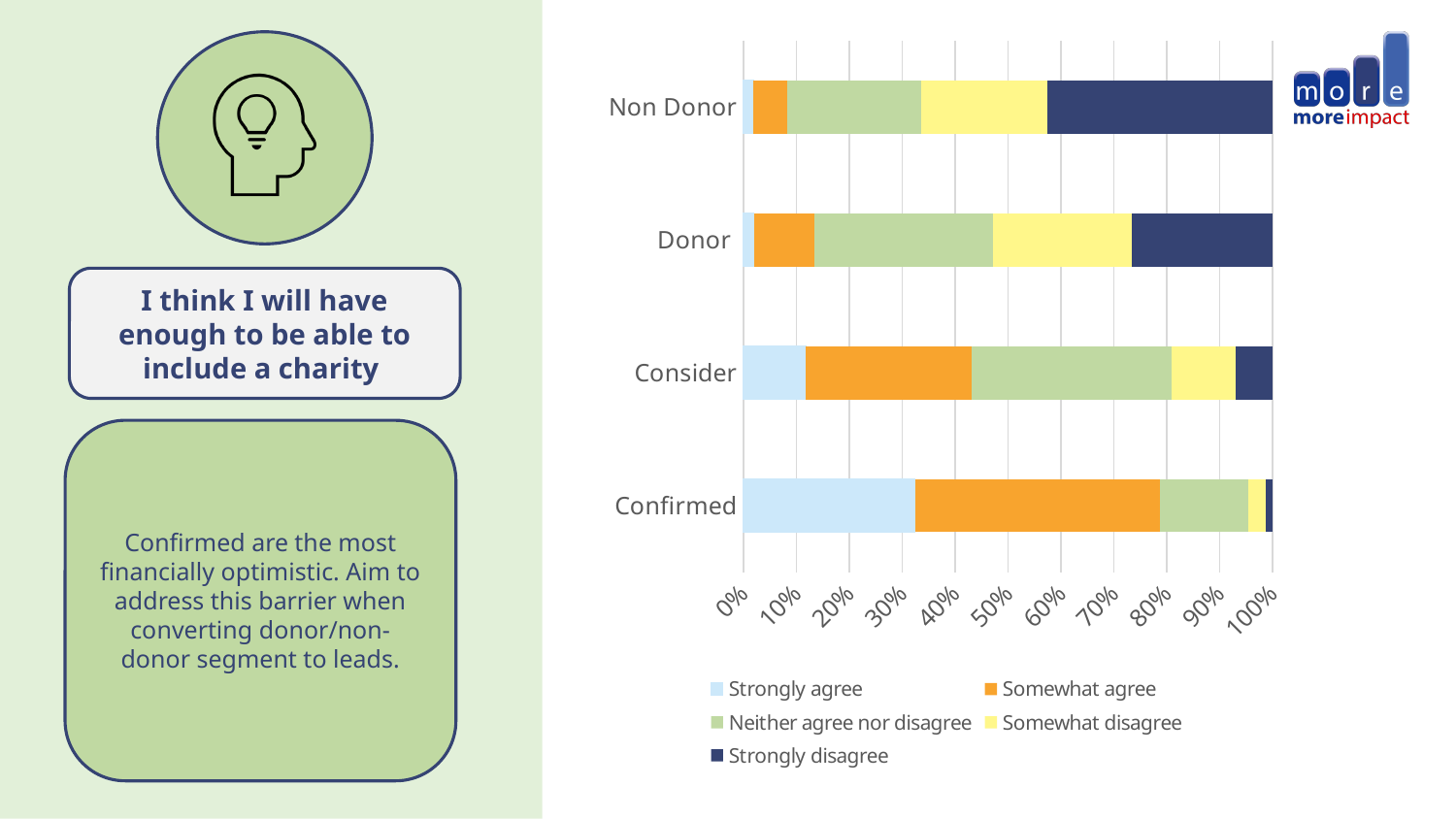
How many categories are plotted on the chart? 4 Which is larger: the Strongly disagree share for Non Donor or for Confirmed? Non Donor What colour represents Strongly disagree in the legend? Dark blue What kind of chart is shown on the slide? Stacked bar chart Which category has the largest Strongly agree share? Confirmed Which category has the largest Strongly disagree share? Non Donor Is the Somewhat agree share for Consider greater or less than 20%? greater Is the Strongly agree share for Confirmed greater or less than 20%? greater How many series does the chart legend list? 5 Is the Strongly disagree share for Non Donor greater or less than 30%? greater Going from Non Donor down to Confirmed, does the Strongly agree share increase or decrease? increase